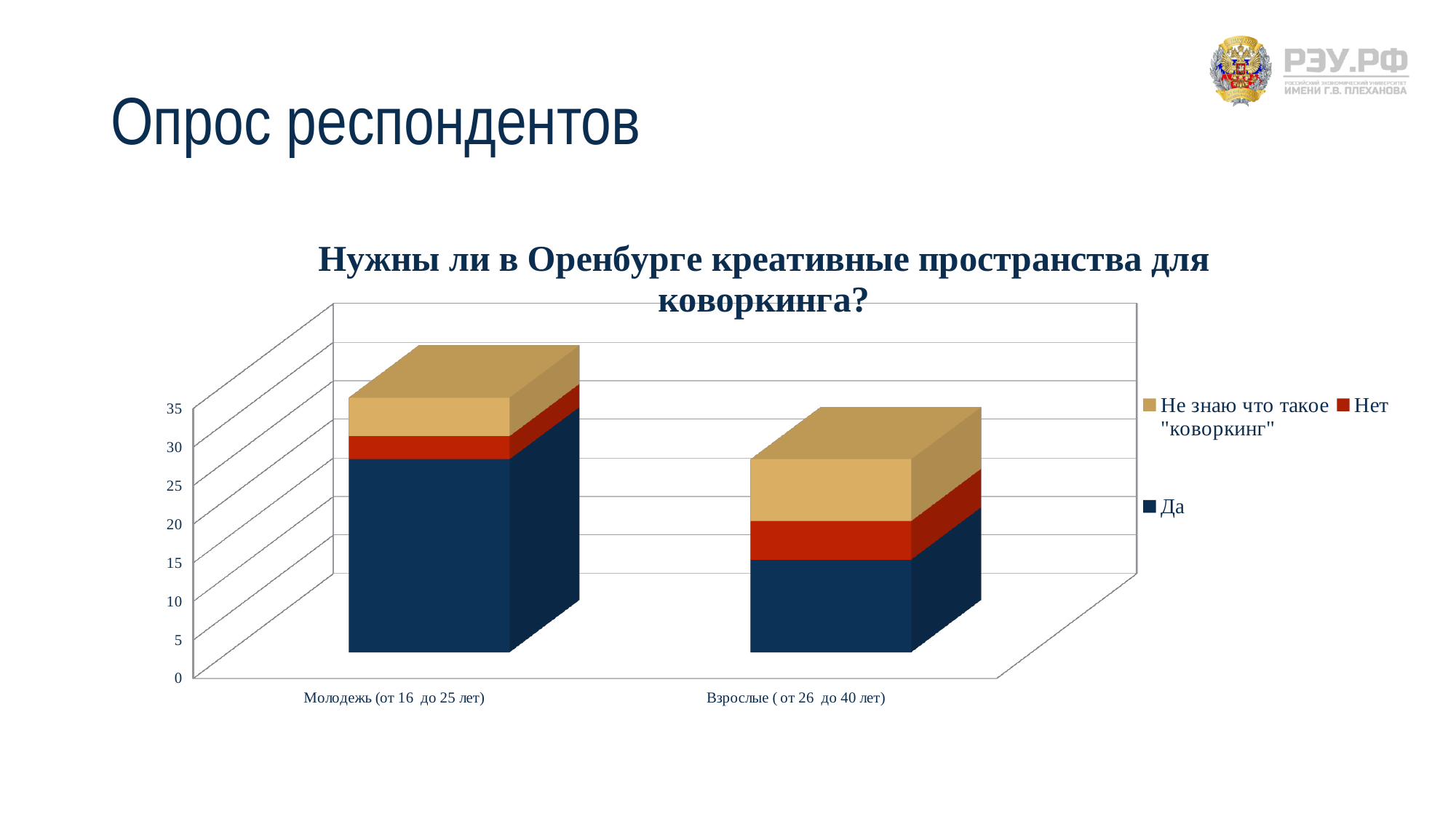
Which category has the shorter stacked bar overall? Взрослые ( от 26 до 40 лет) Which category has the taller stacked bar overall? Молодежь (от 16 до 25 лет) How many categories are shown on the x axis of the chart? 2 Which colour represents the "Да" series in the chart? Dark blue Is the "Да" value for Взрослые ( от 26 до 40 лет) greater or less than 20? less Is the "Да" value for Молодежь (от 16 до 25 лет) greater or less than 20? greater Is the "Да" value for Молодежь (от 16 до 25 лет) larger or smaller than the "Да" value for Взрослые ( от 26 до 40 лет)? larger What is the title of the chart? Нужны ли в Оренбурге креативные пространства для коворкинга? What kind of chart is shown on the slide? Stacked bar chart Is the "Нет" value for Взрослые ( от 26 до 40 лет) larger or smaller than the "Нет" value for Молодежь (от 16 до 25 лет)? larger How many series does the chart's legend list? 3 Which series forms the largest segment of the bar for Молодежь (от 16 до 25 лет)? Да